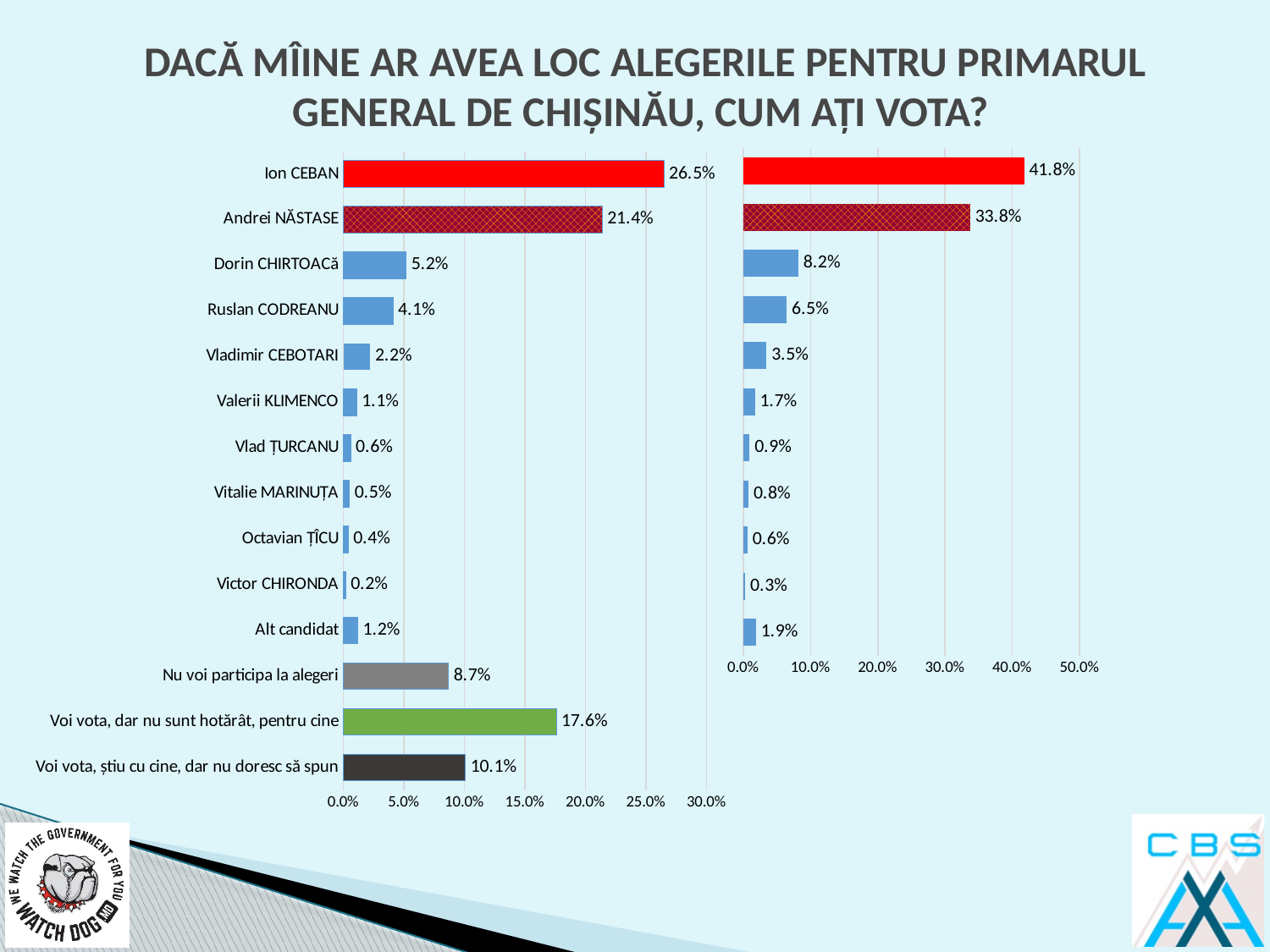
In the right chart, what is the value for Andrei NĂSTASE? 33.8% How many categories are shown in the left chart? 14 In the left chart, what is the difference between Ruslan CODREANU and Vladimir CEBOTARI? 1.9% How many categories are shown in the right chart? 11 In the right chart, what is the difference between Ion CEBAN and Andrei NĂSTASE? 8.0% What kind of chart is the left chart? Bar chart In the left chart, what is the value for 'Voi vota, dar nu sunt hotărât, pentru cine'? 17.6% In the right chart, what is the value for Dorin CHIRTOACă? 8.2% In the left chart, which category has the lowest value? Victor CHIRONDA In the right chart, which category has the highest value? Ion CEBAN In the left chart, what is the value for Ion CEBAN? 26.5% In the left chart, which is larger: the value for 'Nu voi participa la alegeri' or the value for 'Voi vota, știu cu cine, dar nu doresc să spun'? Voi vota, știu cu cine, dar nu doresc să spun